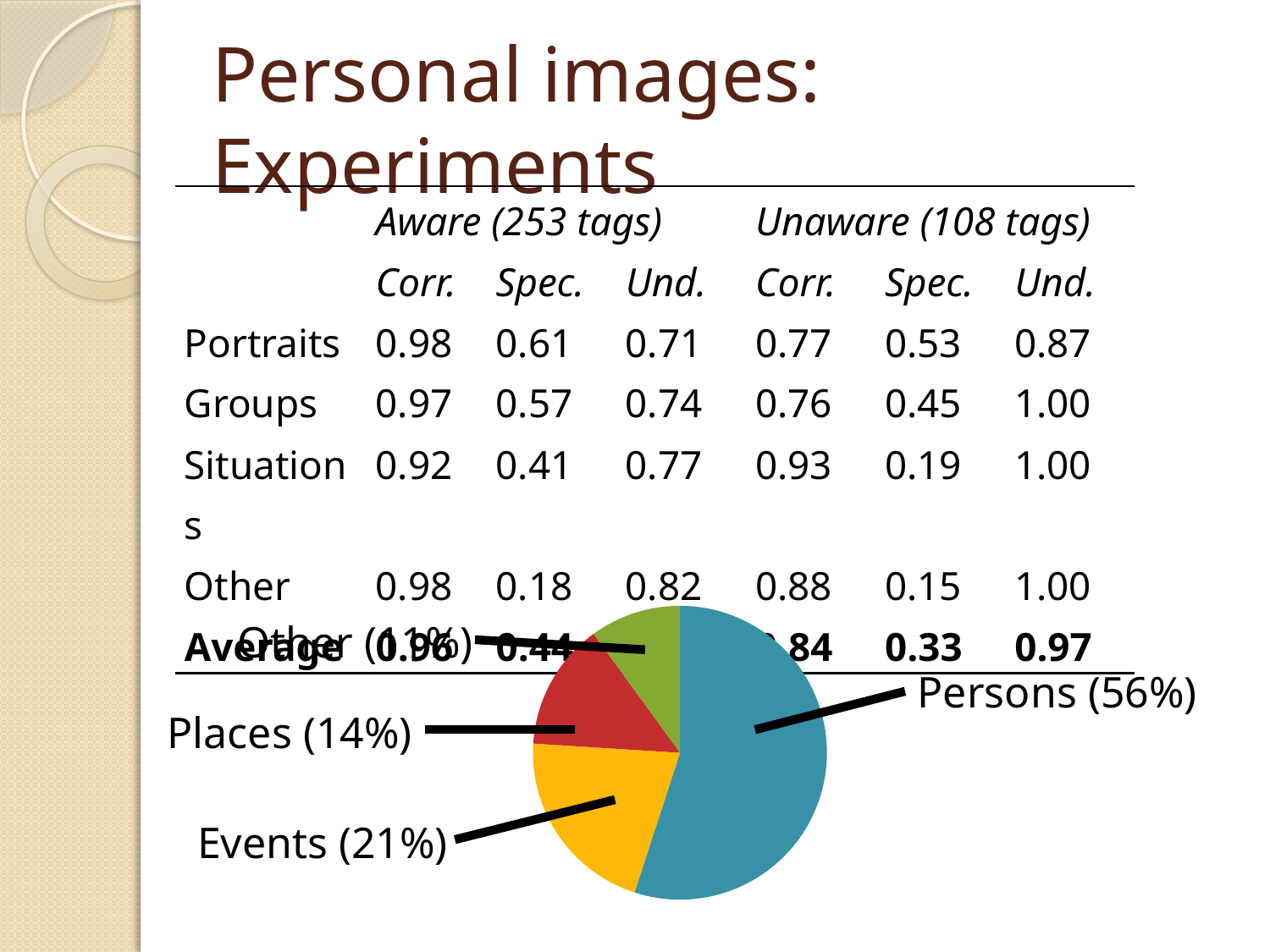
What kind of chart is shown on the slide? pie chart Which is larger in the pie chart, Events or Places? Events What percentage is shown for Events in the pie chart? 21% What is the difference between the Events and Places shares in the pie chart? 7% What colour is the Places slice in the pie chart? red How many slices does the pie chart have? 4 By how many percentage points does Persons exceed Events in the pie chart? 35% What share of the pie chart is Persons? 56% Which category has the smallest slice in the pie chart? Other What percentage is shown for Places in the pie chart? 14% Which category has the largest slice in the pie chart? Persons What colour is the Persons slice in the pie chart? blue